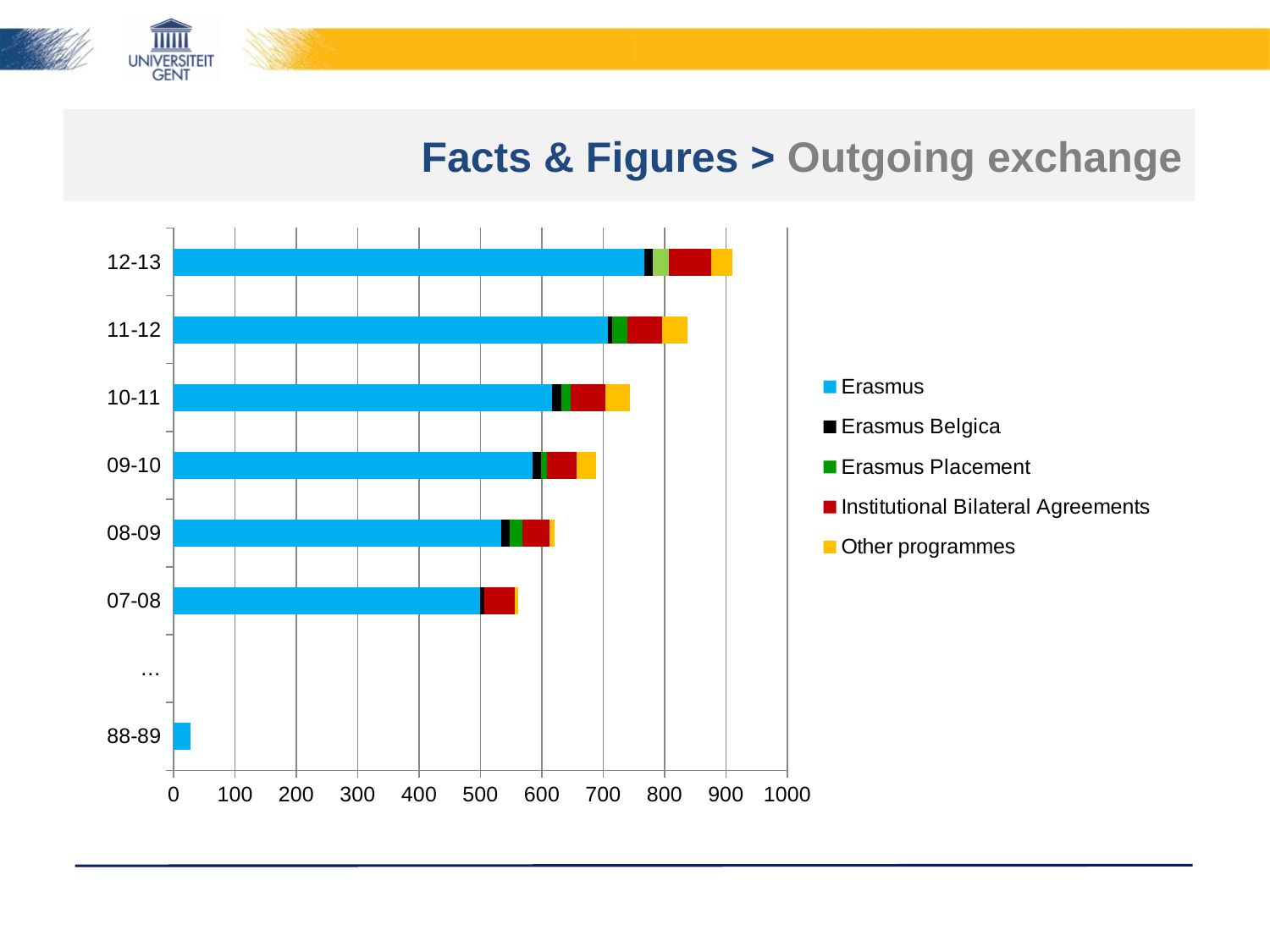
Is the Erasmus segment for 12-13 greater or less than 700? greater Which academic year has the shortest bar? 88-89 Is the total bar for 07-08 greater or less than 500? greater Which has the longer total bar, 10-11 or 08-09? 10-11 Is the value for 88-89 greater or less than 100? less Do the total bars rise or fall from 07-08 to 12-13? rise How many series does the legend list? 5 Which series is shown in light blue in the legend? Erasmus Which academic year has the longest total bar? 12-13 What kind of chart is shown on the slide? stacked bar chart